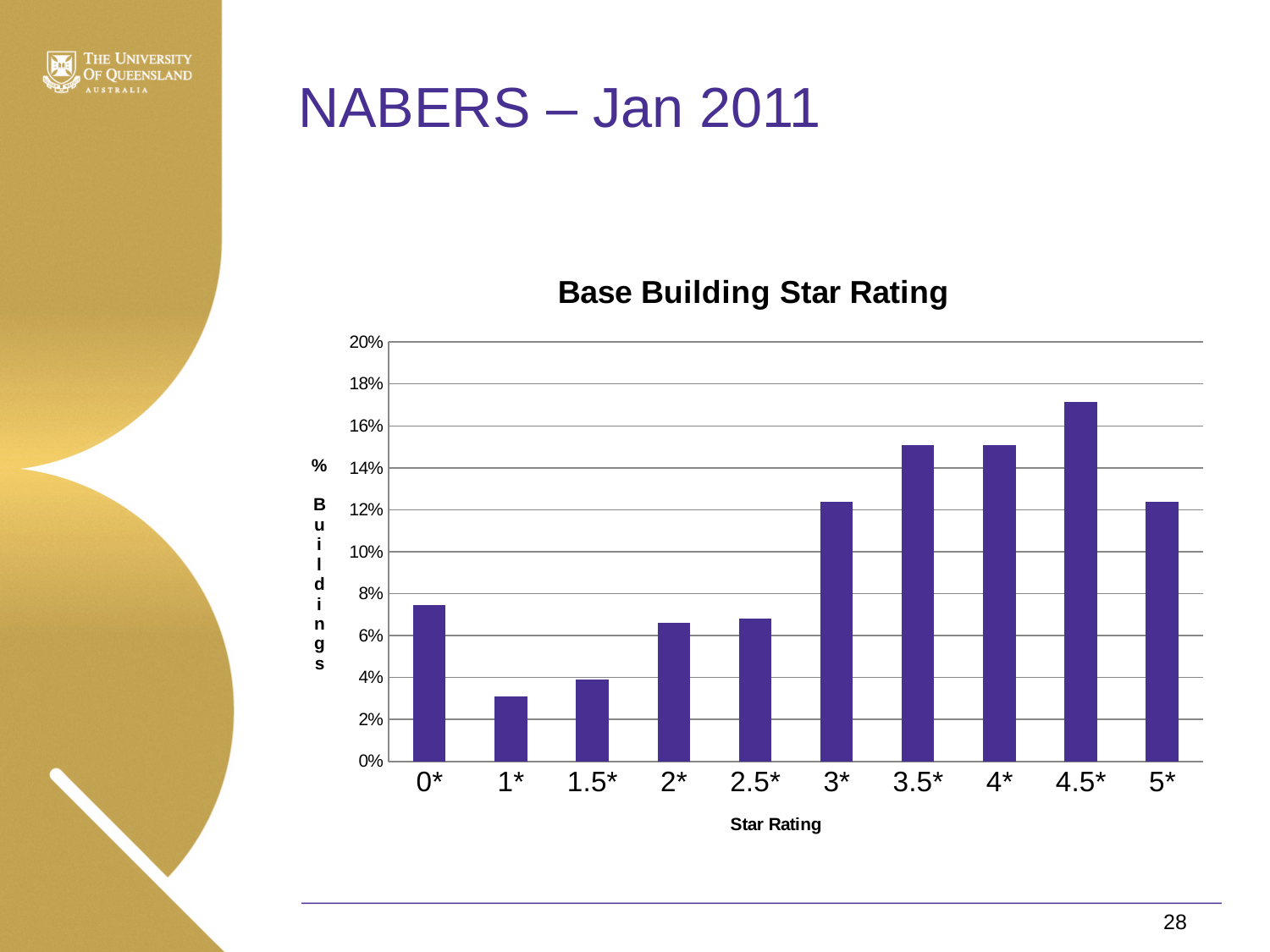
Is the value for 3* greater or less than 10%? greater Which star rating has the highest percentage of buildings? 4.5* Which has a higher percentage of buildings, 3* or 1.5*? 3* How many star rating categories are shown on the x axis? 10 What is the label on the x axis of the chart? Star Rating Is the value for 0* greater or less than 8%? less Is the value for 1* greater or less than 4%? less Which star rating has the lowest percentage of buildings? 1* What type of chart is shown on the slide? bar chart Which has a higher percentage of buildings, 4.5* or 5*? 4.5* What is the title of the chart? Base Building Star Rating